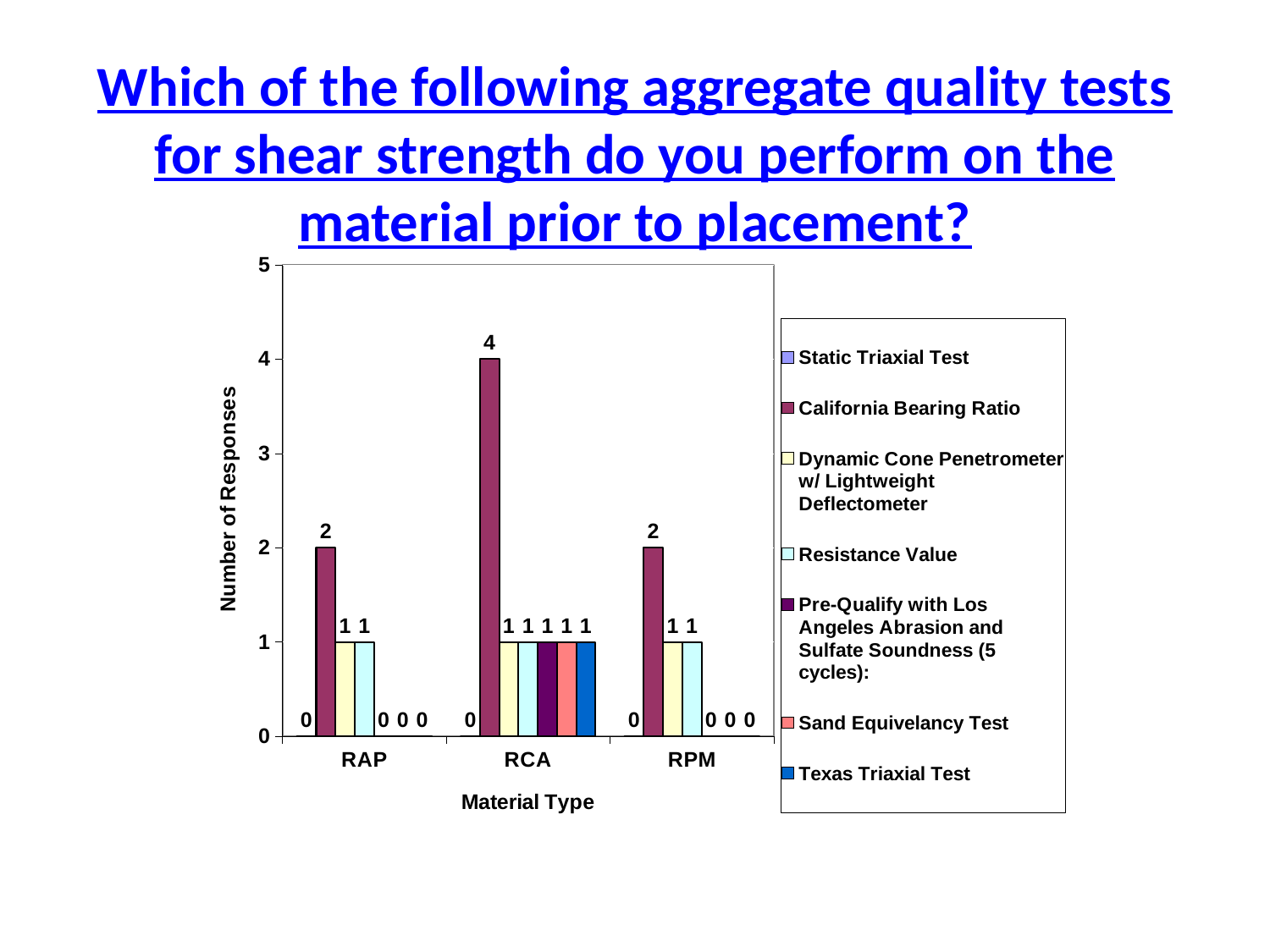
What is the label of the x axis? Material Type How many material types are shown on the x axis? 3 What is the difference in California Bearing Ratio responses between RCA and RPM? 2 What is the number of responses for Texas Triaxial Test for RCA? 1 How many series does the legend list? 7 What is the number of responses for California Bearing Ratio for RAP? 2 What is the label of the y axis? Number of Responses Which is larger: the California Bearing Ratio responses for RCA or for RAP? RCA What type of chart is shown on the slide? Bar chart Which material type has the highest number of responses for California Bearing Ratio? RCA What is the number of responses for California Bearing Ratio for RCA? 4 What is the number of responses for Static Triaxial Test for RPM? 0